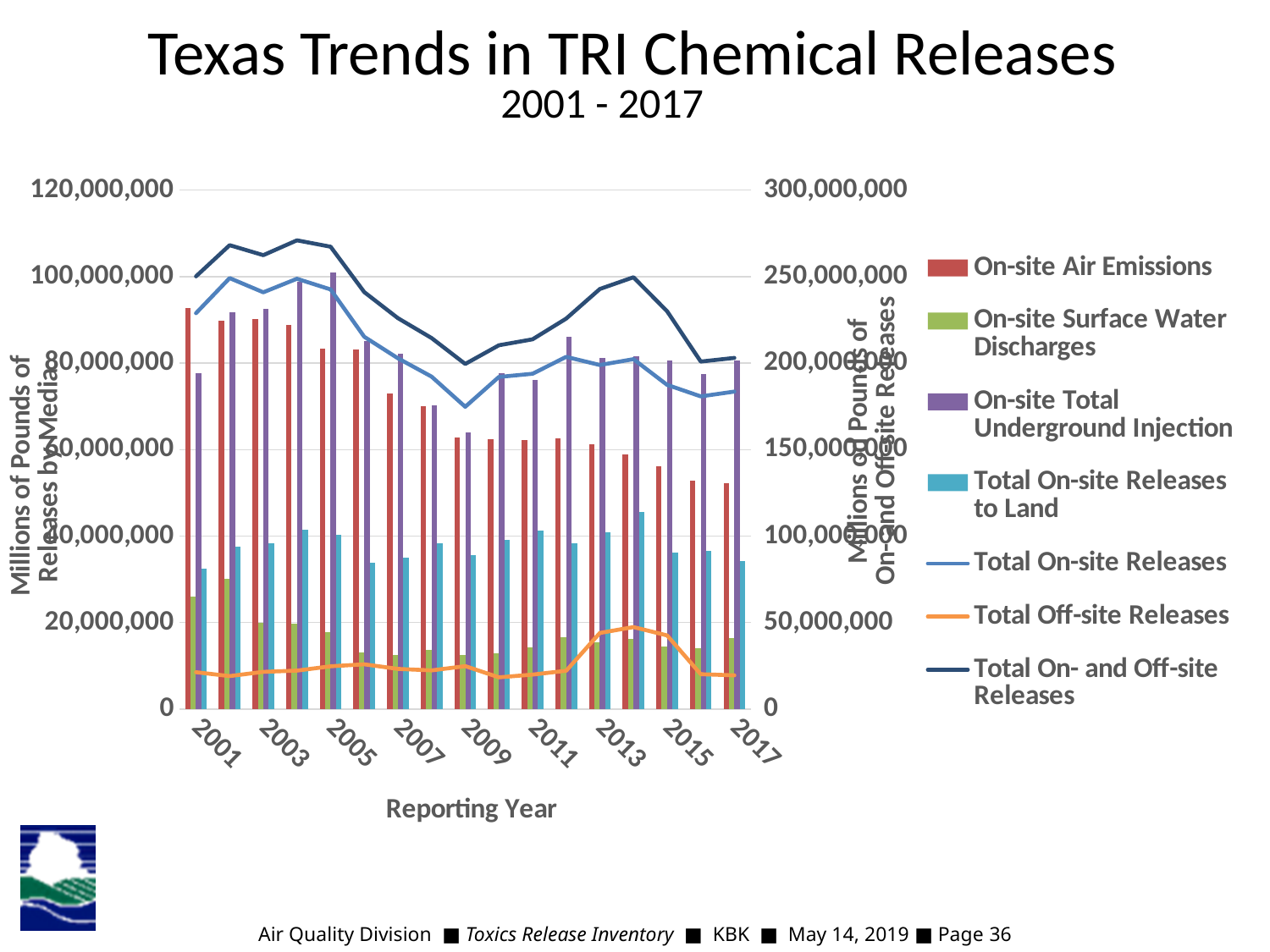
Do On-site Air Emissions generally rise or fall from 2001 to 2017? fall Which is larger, On-site Air Emissions in 2001 or in 2017? 2001 Is the value for Total Off-site Releases in 2013 greater or less than 50,000,000? less Is the value for On-site Air Emissions in 2001 greater or less than 80,000,000? greater What is the label of the x axis? Reporting Year Is the value for Total On- and Off-site Releases in 2004 greater or less than 250,000,000? greater What kind of chart is this? Combined bar and line chart How many reporting years are plotted along the x axis? 17 In which year is On-site Surface Water Discharges highest? 2002 In which year is Total Off-site Releases highest? 2014 How many series does the legend list? 7